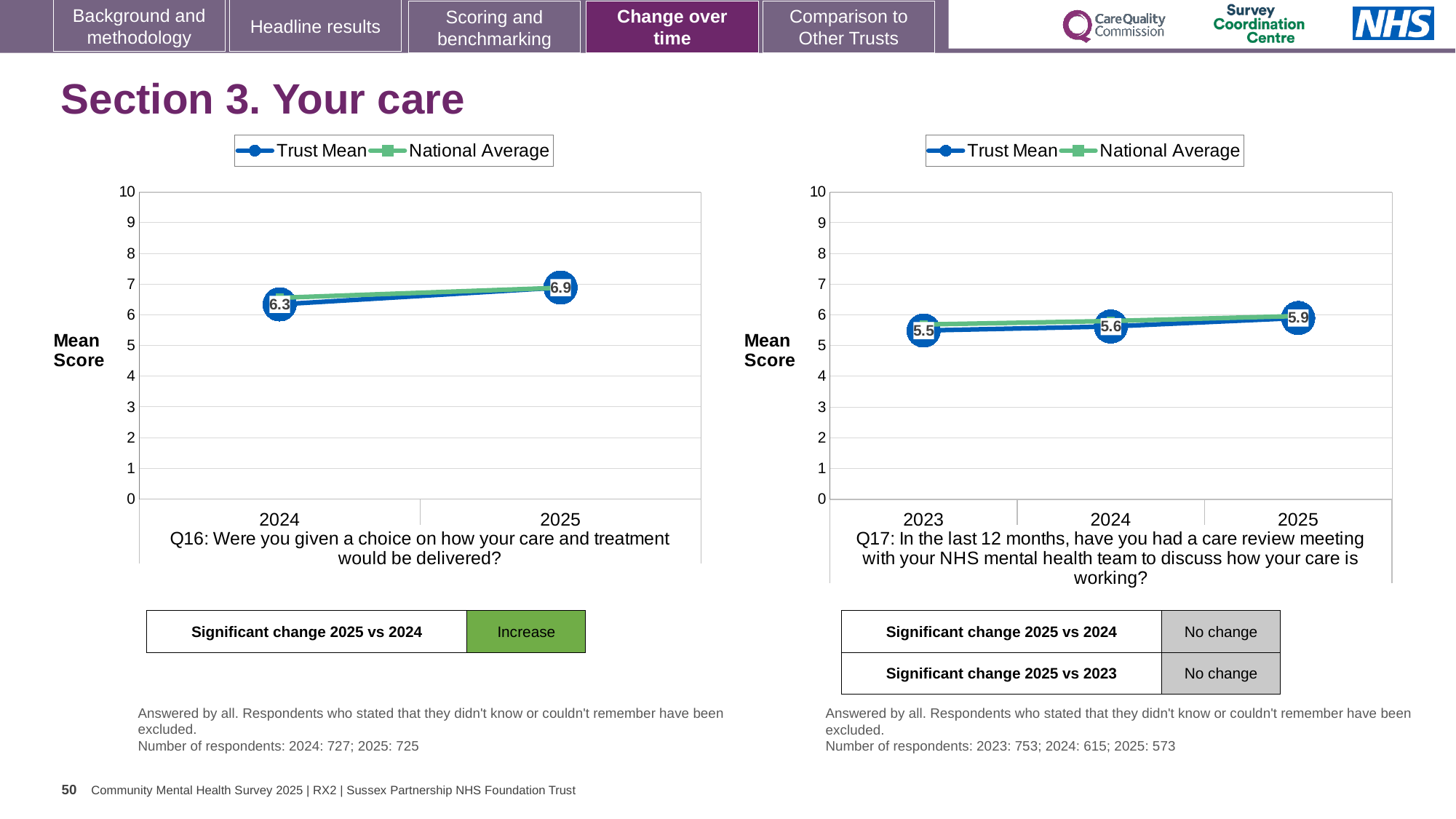
How many series does the legend of the left chart (Q16) list? 2 On the left chart (Q16), does the Trust Mean rise or fall from 2024 to 2025? rise On the right chart (Q17), what is the Trust Mean score for 2023? 5.5 On the right chart (Q17), is the Trust Mean for 2024 greater or less than 6? less On the right chart (Q17), how many years are plotted on the x axis? 3 On the left chart (Q16), what is the Trust Mean score for 2024? 6.3 On the left chart (Q16), what is the Trust Mean score for 2025? 6.9 On the right chart (Q17), what is the Trust Mean score for 2025? 5.9 On the right chart (Q17), what is the difference between the Trust Mean in 2025 and 2023? 0.4 What kind of chart is the right chart (Q17)? line chart On the left chart (Q16), by how much did the Trust Mean change from 2024 to 2025? 0.6 On the right chart (Q17), which year has the highest Trust Mean score? 2025